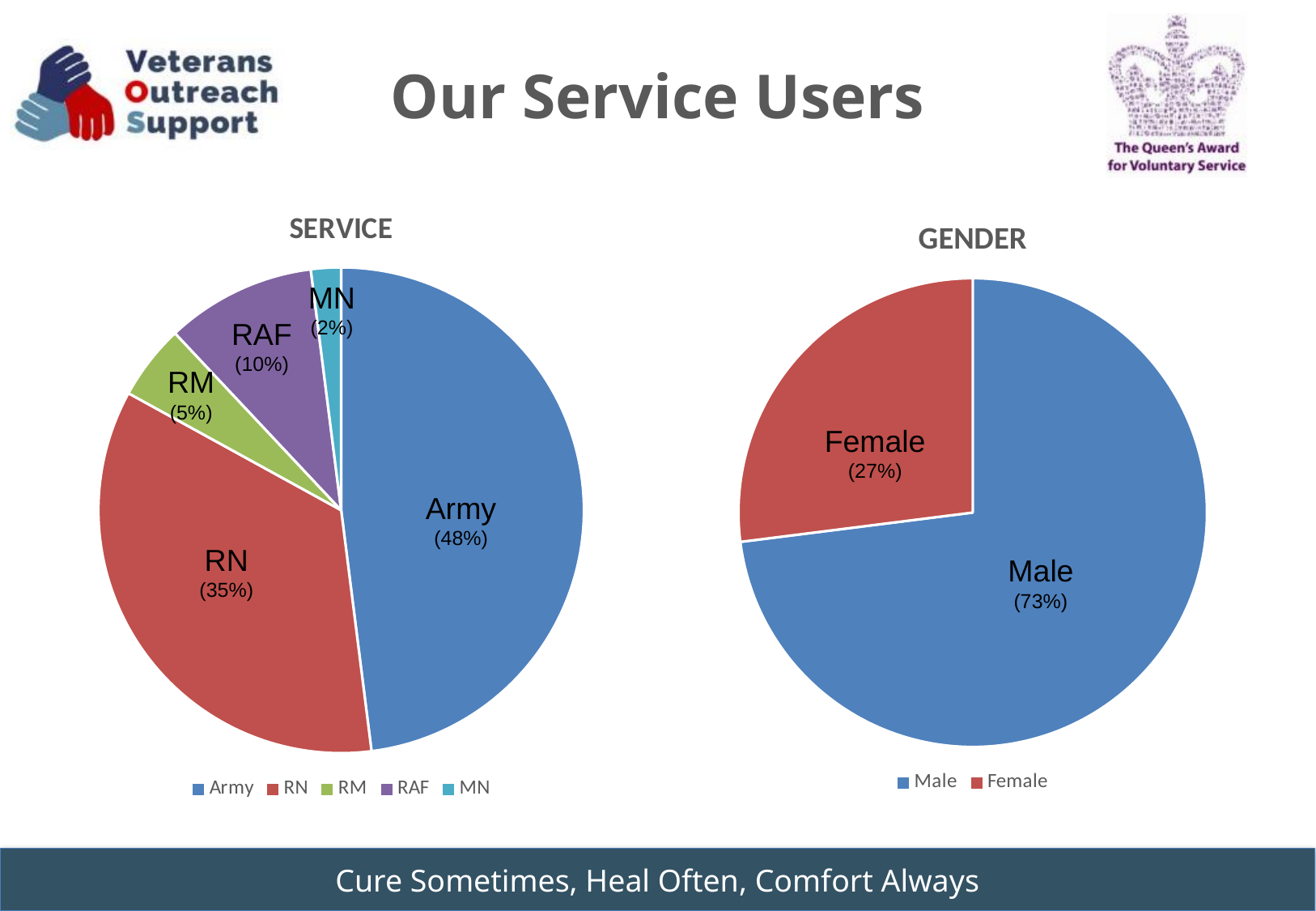
In the SERVICE chart, what colour is the RM slice? Green How many entries does the legend of the GENDER chart list? 2 How many categories does the SERVICE chart show? 5 In the SERVICE chart, what share of service users is Army? 48% In the SERVICE chart, which service has the largest slice? Army In the SERVICE chart, what percentage is shown for RN? 35% In the SERVICE chart, which service has the smallest slice? MN In the GENDER chart, what is the difference in percentage points between Male and Female? 46 In the SERVICE chart, what is the difference in percentage points between Army and RN? 13 What kind of chart is the GENDER chart? Pie chart In the GENDER chart, what share of service users is Female? 27% In the SERVICE chart, which is larger, RAF or RM? RAF